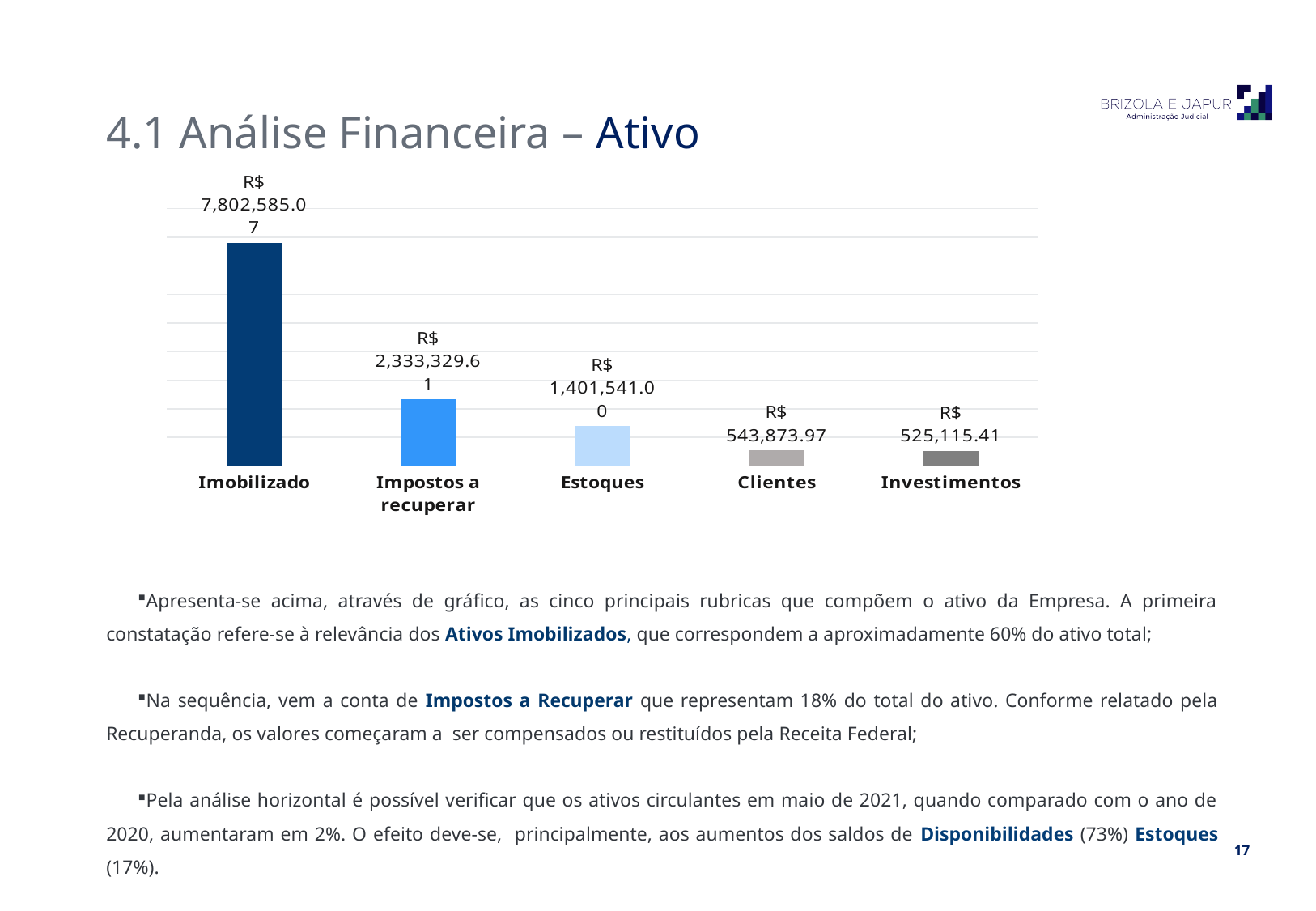
What is the value for Imobilizado? R$ 7,802,585.07 What is the value for Estoques? R$ 1,401,541.00 What kind of chart is shown on the slide? Bar chart Which category has the lowest value? Investimentos What is the difference between the values for Imobilizado and Impostos a recuperar? R$ 5,469,255.46 Which category has the highest value? Imobilizado What is the value for Clientes? R$ 543,873.97 What is the difference between the values for Estoques and Clientes? R$ 857,667.03 What is the value for Investimentos? R$ 525,115.41 How many categories are shown in the chart? 5 What is the value for Impostos a recuperar? R$ 2,333,329.61 Which is larger, the value for Clientes or the value for Investimentos? Clientes